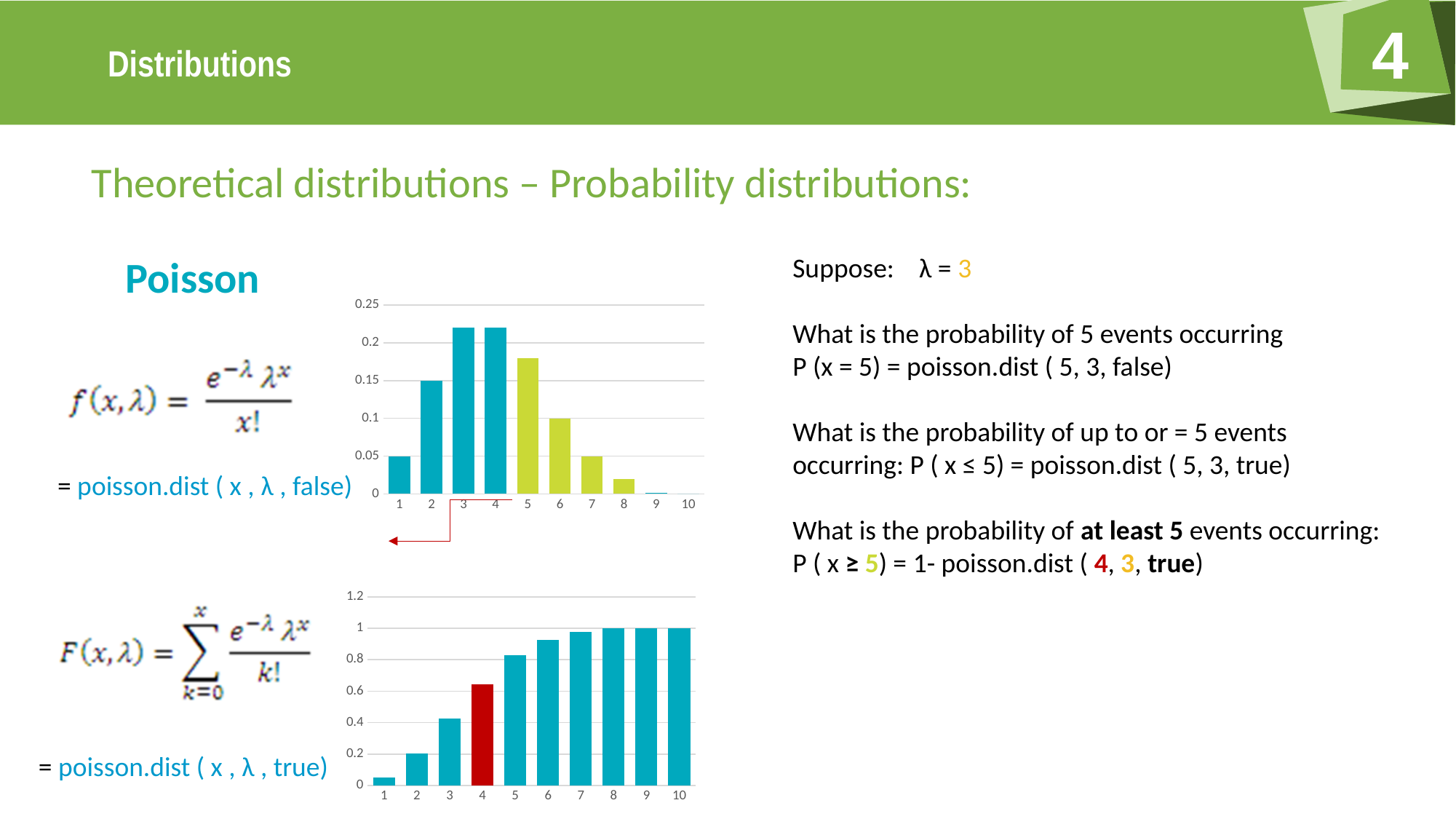
What kind of chart is the top chart on the slide? bar chart In the bottom chart, which category's bar is coloured red? 4 In the top chart, do the values rise or fall from category 5 to category 10? fall In the top chart, is the value for category 5 greater or less than 0.15? greater How many categories are shown on the x axis of the top chart? 10 In the top chart, is the value for category 6 greater or less than 0.15? less In the bottom chart, do the values rise or fall as the x axis goes from 1 to 10? rise In the top chart, which categories are drawn in yellow-green rather than teal? 5, 6, 7 and 8 In the top chart, is the value for category 3 greater or less than 0.2? greater In the top chart, which is larger, the value for category 2 or the value for category 6? category 2 What kind of chart is the bottom chart on the slide? bar chart